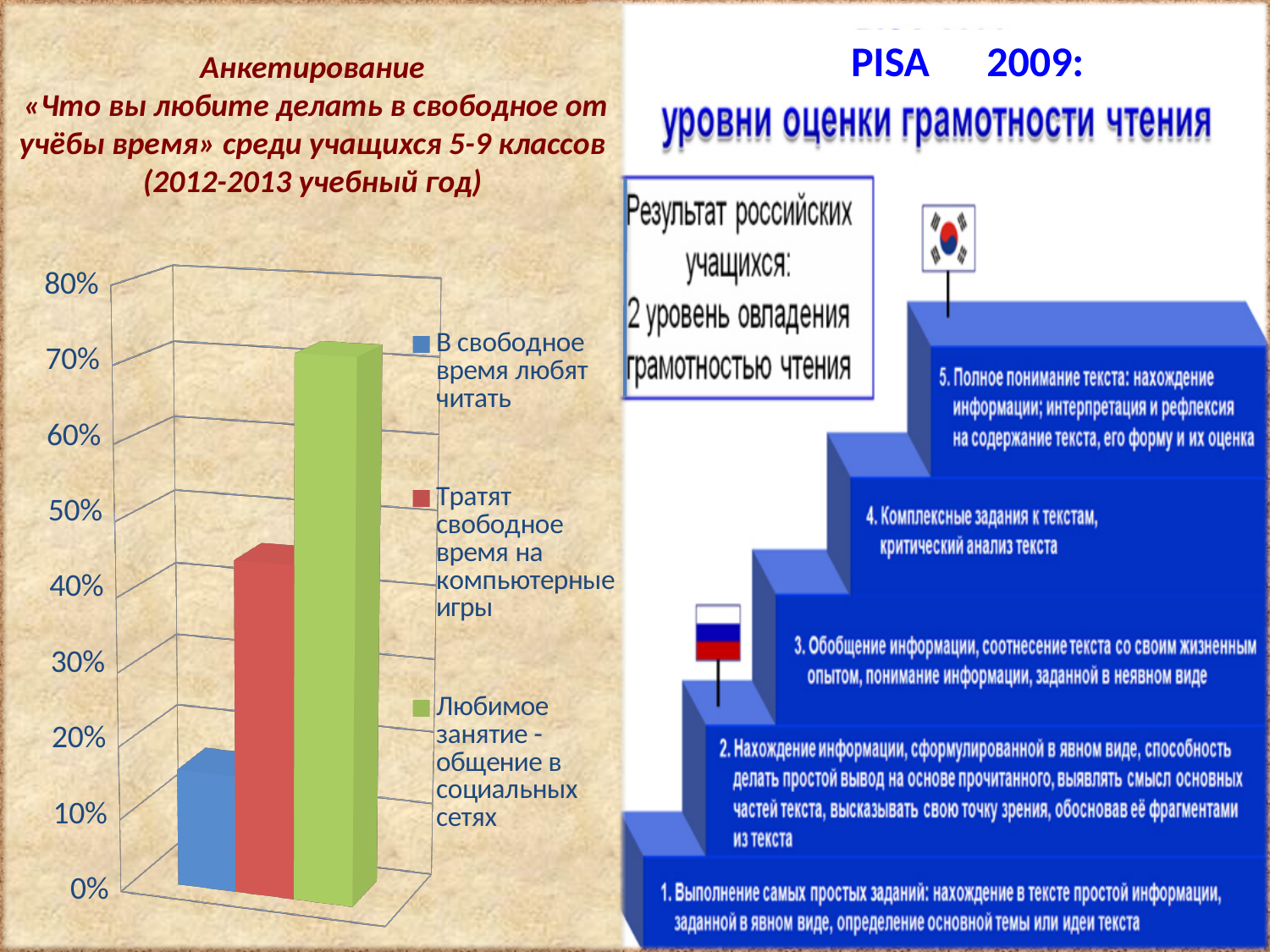
How many bars are plotted in the bar chart? 3 In the bar chart, is the value for 'Любимое занятие - общение в социальных сетях' greater or less than 60%? greater What kind of chart is shown on the left side of the slide? bar chart In the bar chart, which is larger: the value for 'Тратят свободное время на компьютерные игры' or the value for 'В свободное время любят читать'? Тратят свободное время на компьютерные игры What colour is the bar for 'Тратят свободное время на компьютерные игры' in the bar chart? red In the bar chart, which is larger: the value for 'Любимое занятие - общение в социальных сетях' or the value for 'Тратят свободное время на компьютерные игры'? Любимое занятие - общение в социальных сетях In the bar chart, which series has the highest value? Любимое занятие - общение в социальных сетях In the bar chart, which series has the lowest value? В свободное время любят читать How many series does the legend of the bar chart list? 3 In the bar chart, is the value for 'В свободное время любят читать' greater or less than 30%? less In the bar chart, is the value for 'Тратят свободное время на компьютерные игры' greater or less than 50%? less What is the highest value shown on the vertical axis of the bar chart? 80%